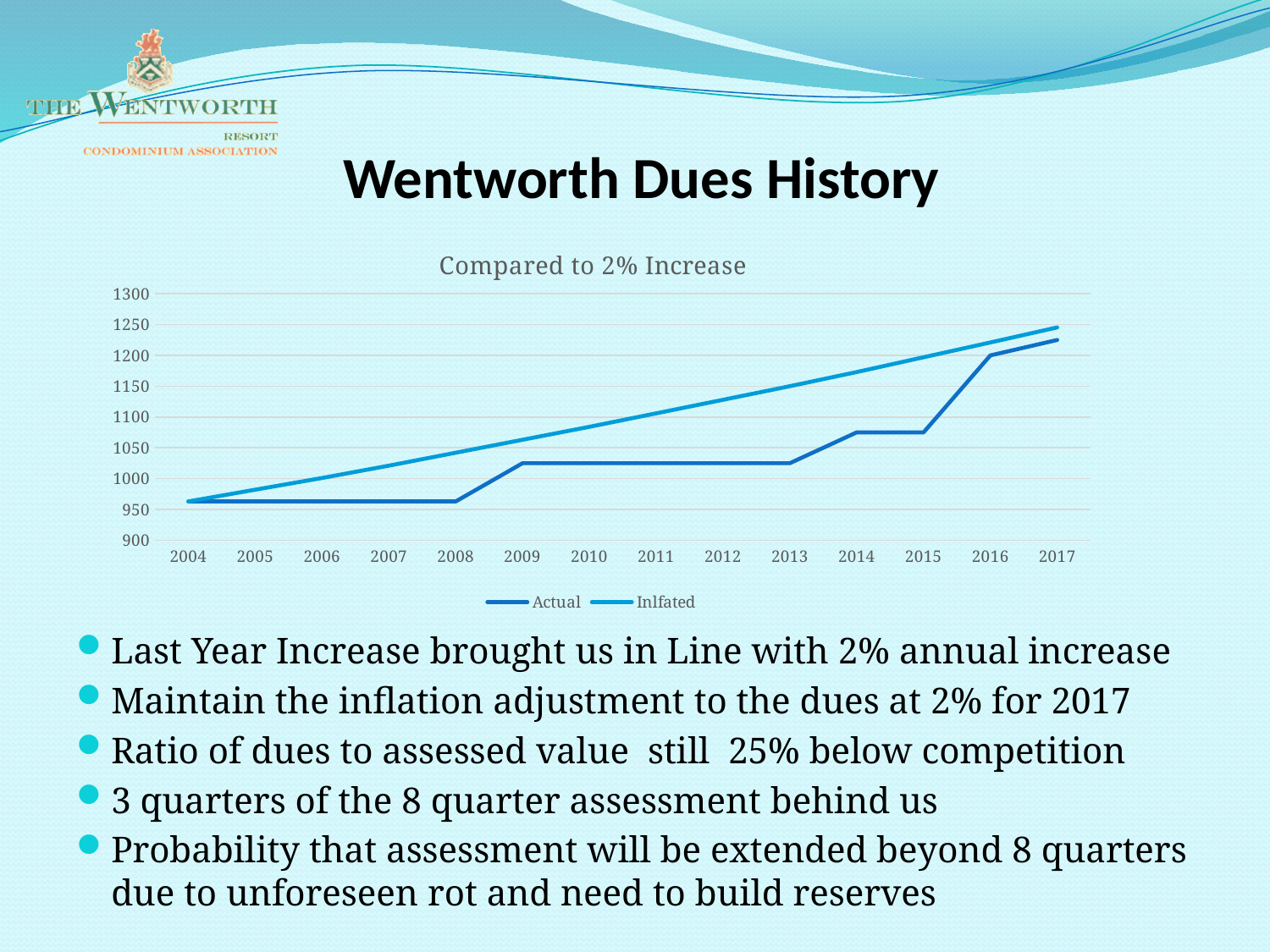
In 2012, which series has the higher value, Actual or Inlfated? Inlfated What kind of chart is shown on the slide? line chart What is the title printed above the chart? Compared to 2% Increase How many series does the chart legend list? 2 Does the Inlfated series rise or fall from 2004 to 2017? rise Is the Actual value for 2010 greater or less than 1050? less How many years are shown along the x axis of the chart? 14 Is the Inlfated value for 2013 greater or less than 1100? greater What are the two series named in the chart legend? Actual and Inlfated Is the Actual value for 2006 greater or less than 1000? less